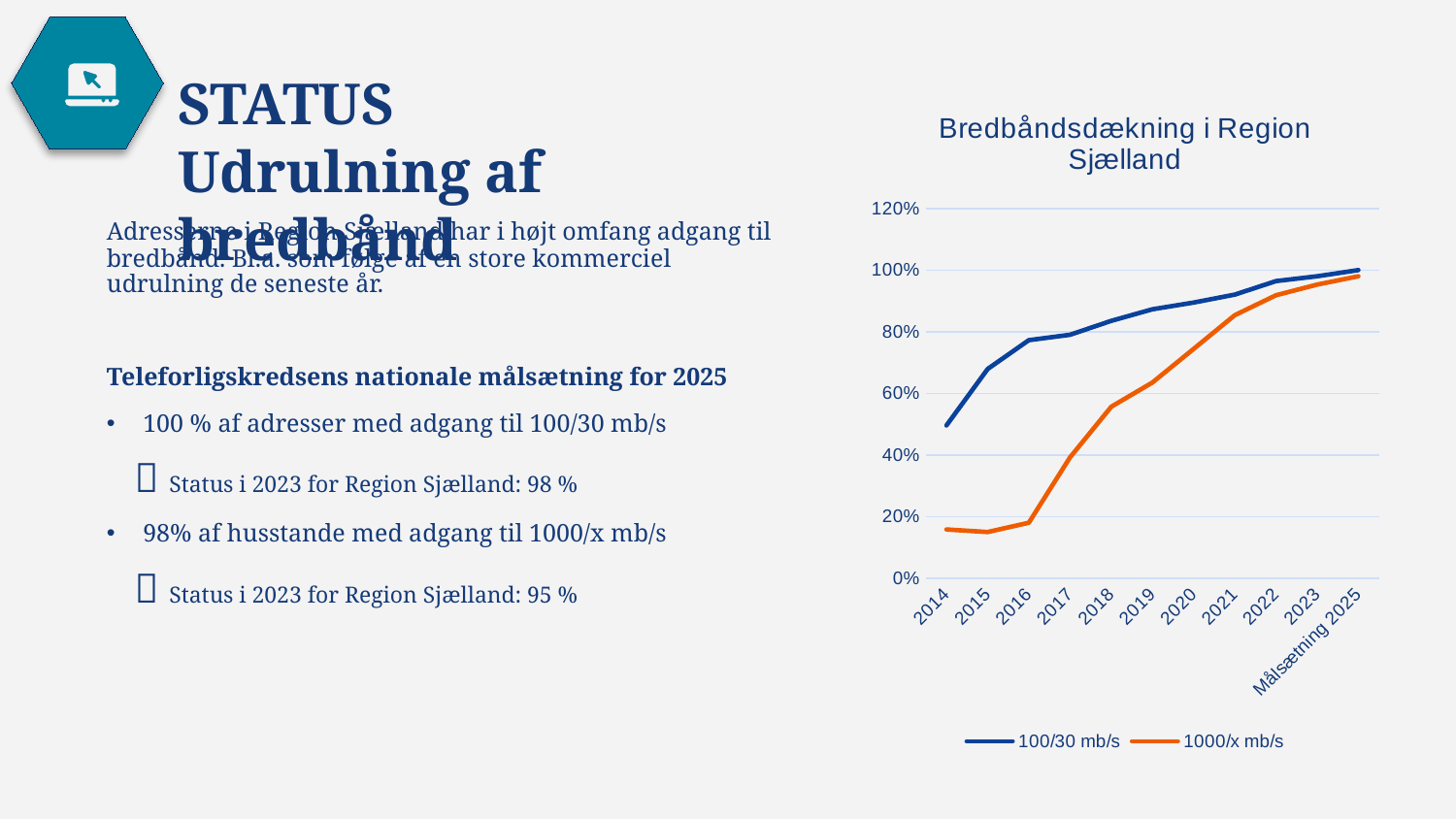
Is the value for 1000/x mb/s in 2018 greater or less than 40%? greater Is the value for 1000/x mb/s in 2014 greater or less than 20%? less What is the title of the chart? Bredbåndsdækning i Region Sjælland In 2018, which series has the higher value, 100/30 mb/s or 1000/x mb/s? 100/30 mb/s How many categories are shown along the x axis of the chart? 11 Is the value for 100/30 mb/s in 2019 greater or less than 80%? greater Do the values for 1000/x mb/s rise or fall from 2016 to 2023? rise What kind of chart is shown on the slide? line chart Which series is drawn in orange in the chart? 1000/x mb/s How many series does the legend of the chart list? 2